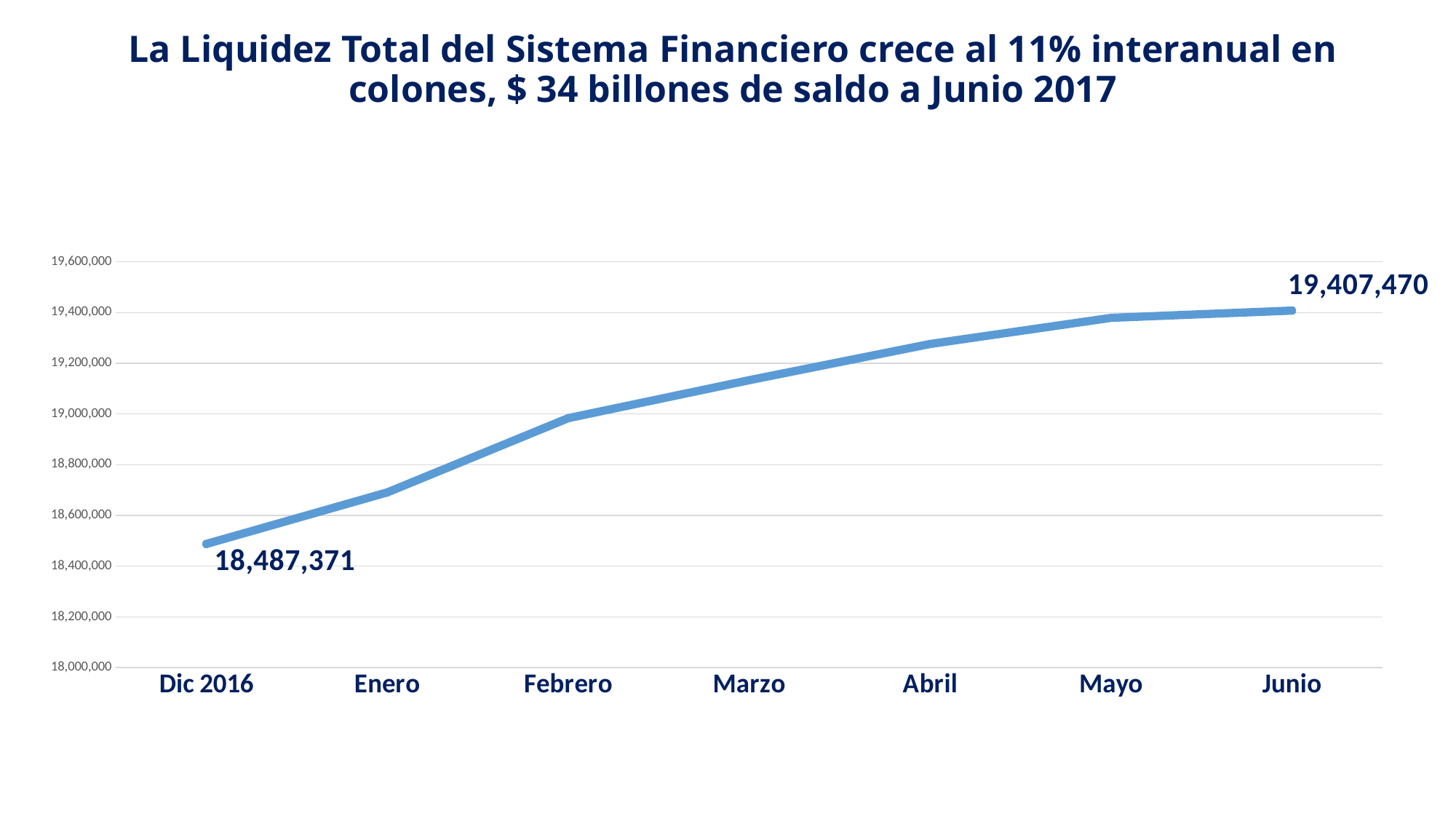
What is the value for Dic 2016? 18,487,371 Which month has the lowest value? Dic 2016 Do the values rise or fall from Dic 2016 to Junio? rise What is the difference between the value for Junio and the value for Dic 2016? 920,099 Is the value for Marzo greater or less than 19,000,000? greater Is the value for Enero greater or less than 18,800,000? less Is the value for Abril greater or less than 19,200,000? greater Which is larger, the value for Abril or the value for Enero? Abril What is the value for Junio? 19,407,470 Which month has the highest value? Junio How many months are plotted on the x axis? 7 What kind of chart is shown on the slide? line chart